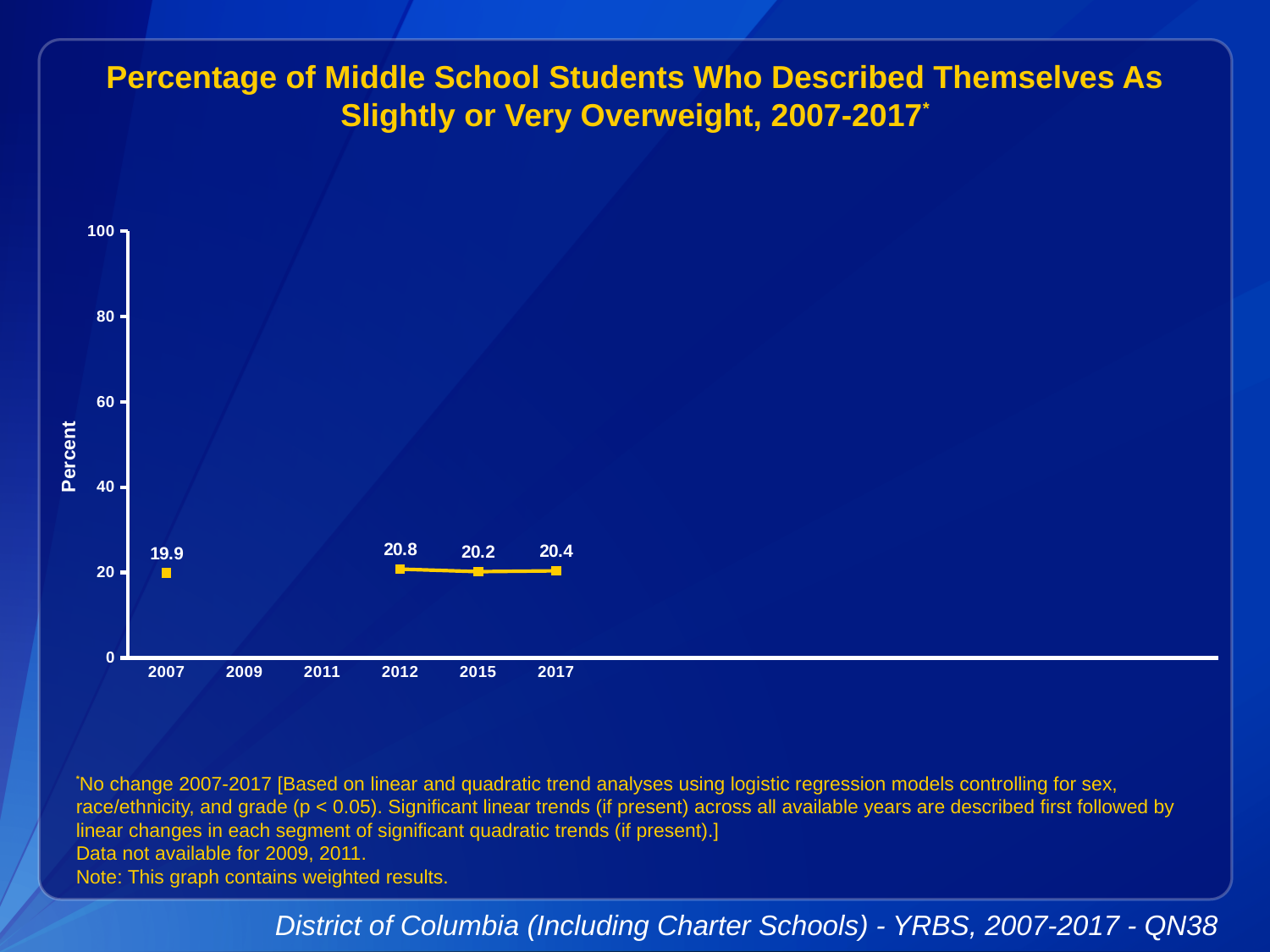
What is the value for 2017? 20.4 How many years have data points plotted on the chart? 4 Which year has the lowest value? 2007 What is the value for 2012? 20.8 What is the label on the y axis? Percent Is the value for 2012 greater or less than 40? less What is the value for 2007? 19.9 Which year has the highest value? 2012 Which is larger, the value for 2017 or the value for 2015? 2017 What is the value for 2015? 20.2 What kind of chart is shown on the slide? line chart What is the difference between the values for 2012 and 2007? 0.9